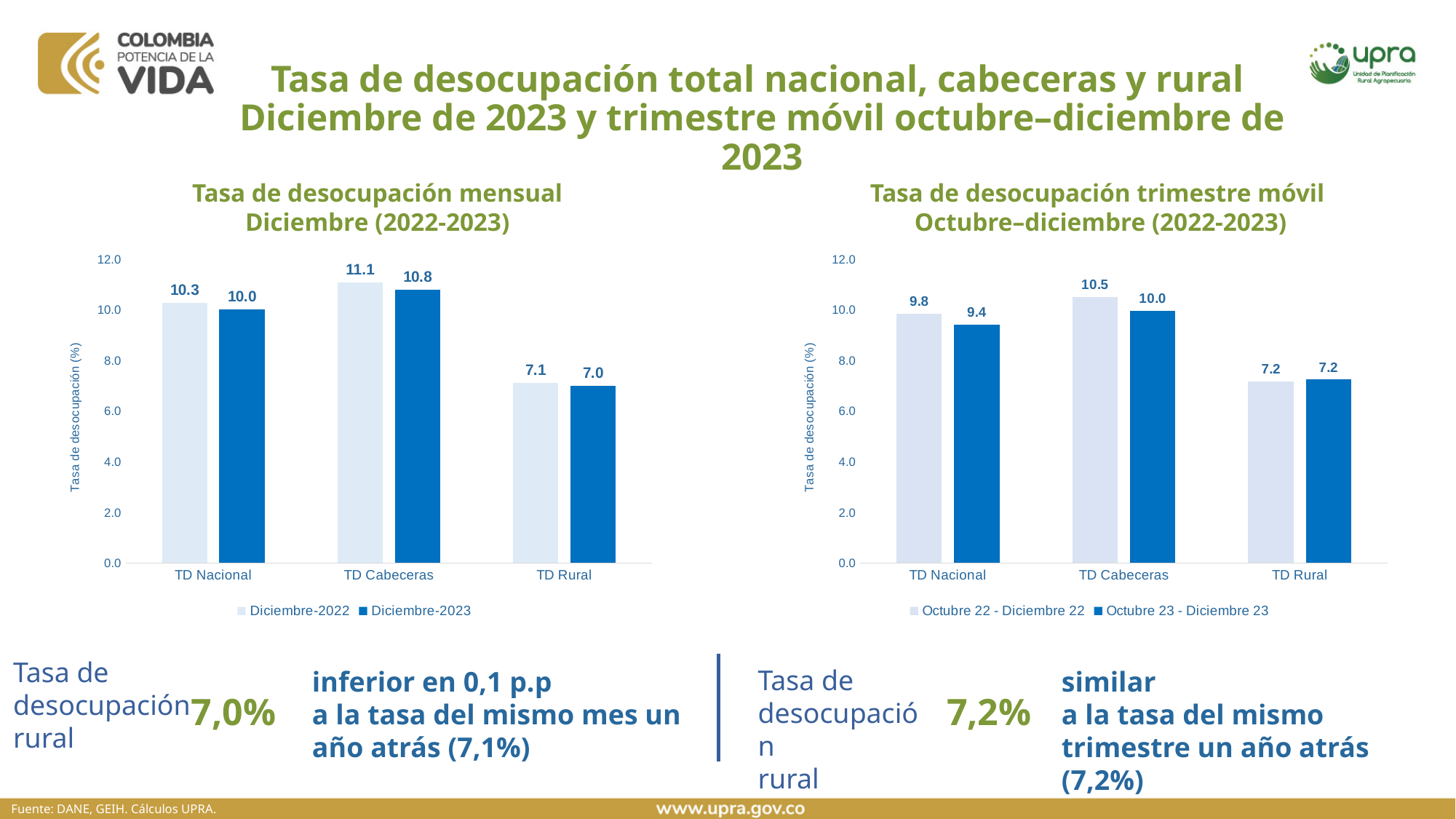
In the left chart (Tasa de desocupación mensual Diciembre), what is the value for TD Rural in Diciembre-2022? 7.1 In the right chart (Tasa de desocupación trimestre móvil), what is the difference between the TD Cabeceras values for Octubre 22 - Diciembre 22 and Octubre 23 - Diciembre 23? 0.5 What kind of chart is the left chart (Tasa de desocupación mensual Diciembre)? Bar chart In the left chart (Tasa de desocupación mensual Diciembre), what is the value for TD Cabeceras in Diciembre-2023? 10.8 How many series does the legend of the right chart (Tasa de desocupación trimestre móvil) list? 2 In the right chart (Tasa de desocupación trimestre móvil), which category has the lowest value for Octubre 23 - Diciembre 23? TD Rural How many categories are shown on the x axis of the left chart (Tasa de desocupación mensual Diciembre)? 3 In the right chart (Tasa de desocupación trimestre móvil), what is the value for TD Nacional in Octubre 23 - Diciembre 23? 9.4 In the left chart (Tasa de desocupación mensual Diciembre), what is the difference between the TD Nacional values for Diciembre-2022 and Diciembre-2023? 0.3 What is the y-axis label of the right chart (Tasa de desocupación trimestre móvil)? Tasa de desocupación (%) In the right chart (Tasa de desocupación trimestre móvil), which is larger for TD Nacional: Octubre 22 - Diciembre 22 or Octubre 23 - Diciembre 23? Octubre 22 - Diciembre 22 In the left chart (Tasa de desocupación mensual Diciembre), which category has the highest value for Diciembre-2022? TD Cabeceras